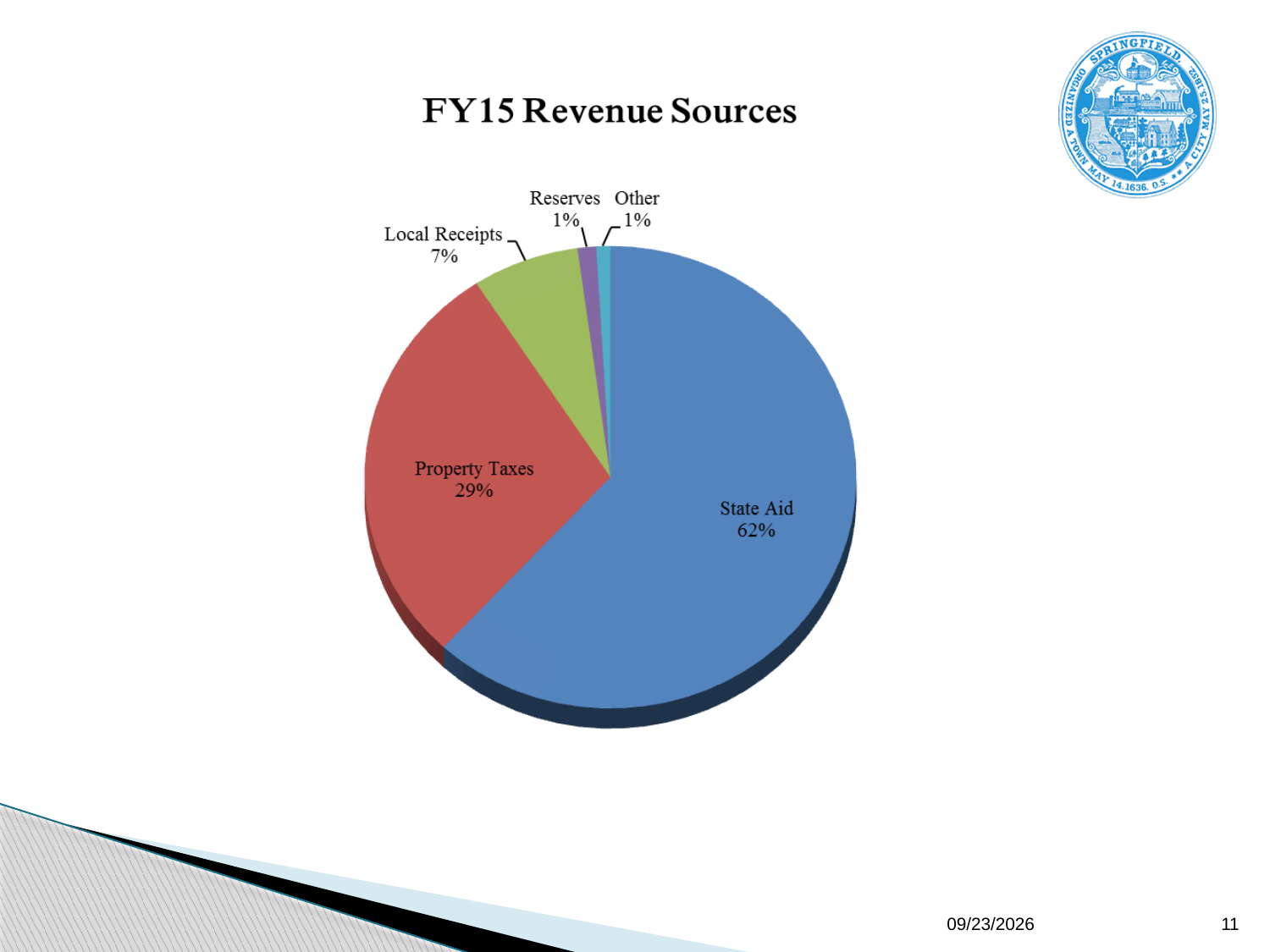
What is the difference in percentage points between State Aid and Property Taxes? 33 What share of FY15 revenue comes from State Aid? 62% What share of FY15 revenue comes from Local Receipts? 7% What kind of chart is shown on the slide? Pie chart Which revenue source has the largest share of the pie? State Aid How many revenue sources are shown in the pie chart? 5 What share of FY15 revenue comes from Reserves? 1% What share of FY15 revenue comes from Property Taxes? 29% Which is larger, the share for Property Taxes or the share for Local Receipts? Property Taxes What is the title of the chart? FY15 Revenue Sources What is the combined share of Property Taxes and Local Receipts? 36% What colour is the State Aid slice? Blue